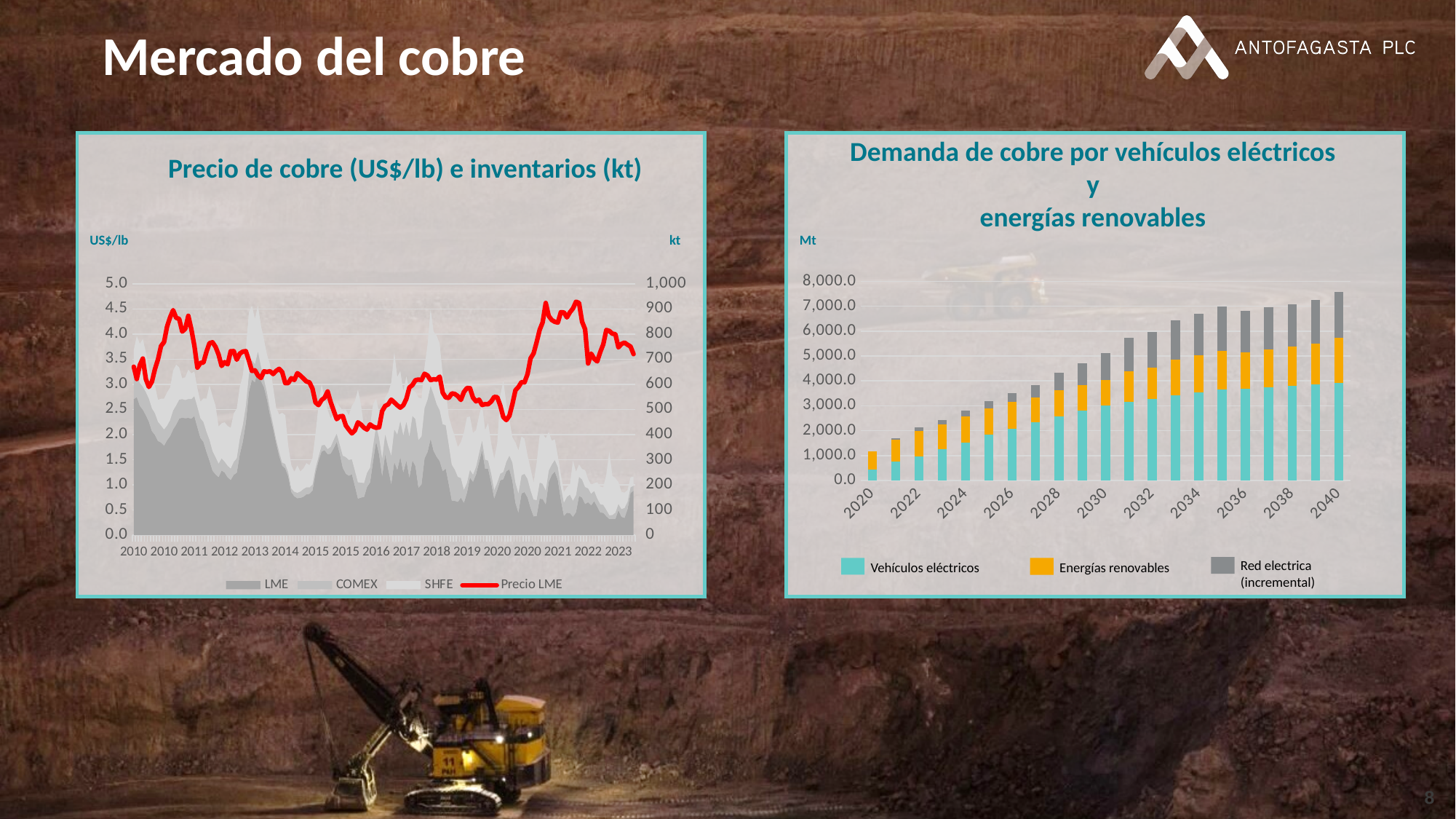
In the 'Demanda de cobre por vehículos eléctricos y energías renovables' chart, what unit is shown on the vertical axis label? Mt In the 'Precio de cobre (US$/lb) e inventarios (kt)' chart, what colour is the Precio LME line? Red How many series does the legend of the 'Precio de cobre (US$/lb) e inventarios (kt)' chart list? 4 In the 'Demanda de cobre por vehículos eléctricos y energías renovables' chart, which year has the tallest bar? 2040 In the 'Demanda de cobre por vehículos eléctricos y energías renovables' chart, do the bar totals rise or fall from 2020 to 2040? Rise How many series does the legend of the 'Demanda de cobre por vehículos eléctricos y energías renovables' chart list? 3 In the 'Demanda de cobre por vehículos eléctricos y energías renovables' chart, is the total bar for 2020 greater or less than 2,000.0? less In the 'Demanda de cobre por vehículos eléctricos y energías renovables' chart, is the total bar for 2034 greater or less than 6,000.0? greater In the 'Demanda de cobre por vehículos eléctricos y energías renovables' chart, is the total bar for 2040 greater or less than 7,000.0? greater In the 'Demanda de cobre por vehículos eléctricos y energías renovables' chart, which year has the shortest bar? 2020 What kind of chart is the 'Demanda de cobre por vehículos eléctricos y energías renovables' chart? Stacked bar chart